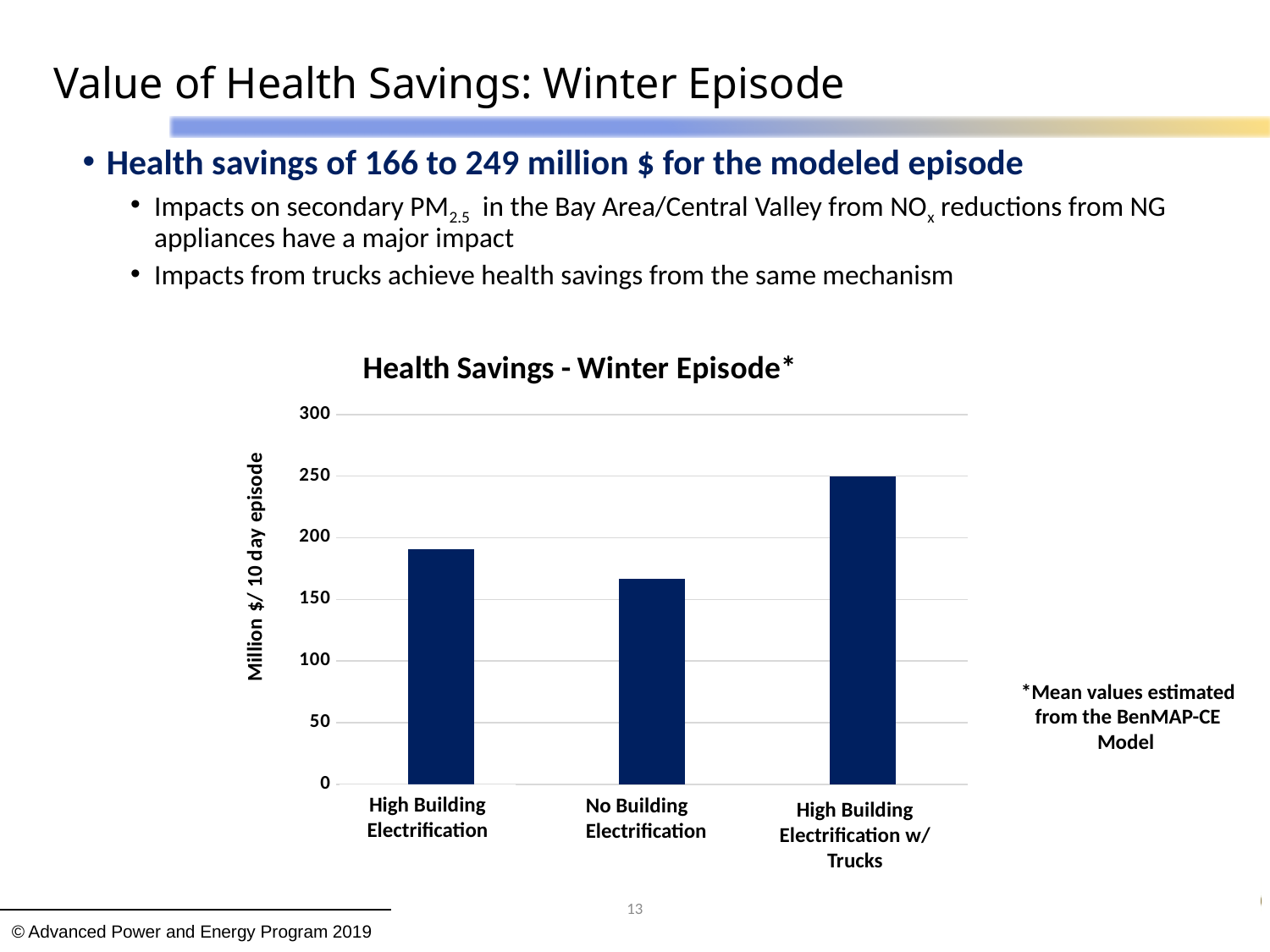
What is the title of the chart? Health Savings - Winter Episode* What type of chart is shown on the slide? bar chart Which is larger, the value for High Building Electrification or the value for No Building Electrification? High Building Electrification What is the y-axis label of the chart? Million $/ 10 day episode Is the value for High Building Electrification greater or less than 250? less Is the value for High Building Electrification greater or less than 150? greater Which category has the lowest value in the chart? No Building Electrification Is the value for No Building Electrification greater or less than 200? less Which category has the highest value in the chart? High Building Electrification w/ Trucks Which is larger, the value for No Building Electrification or the value for High Building Electrification w/ Trucks? High Building Electrification w/ Trucks How many categories are shown on the x axis of the chart? 3